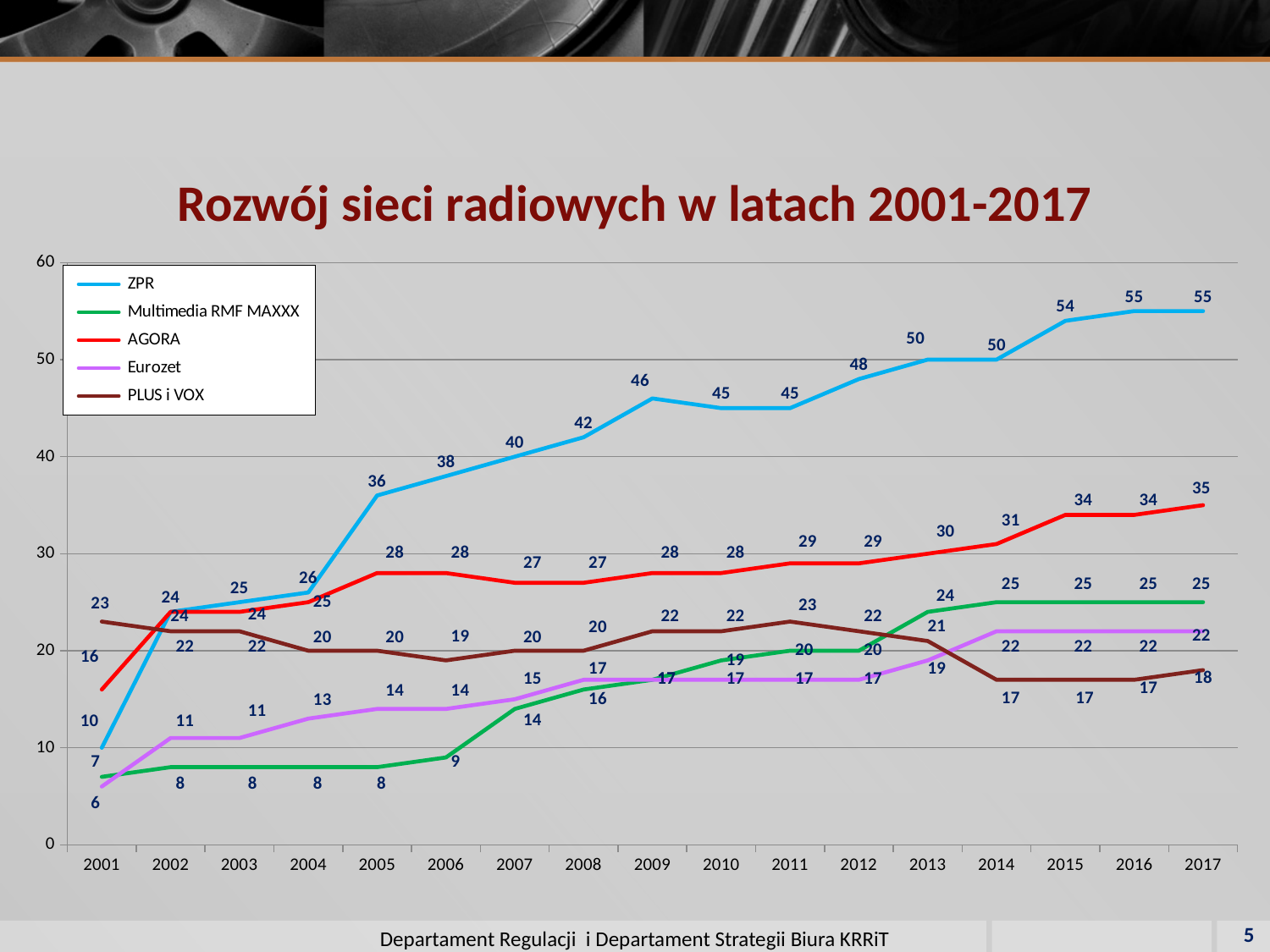
What is the difference between the ZPR value in 2017 and the ZPR value in 2001? 45 Which is larger in 2001: the value for PLUS i VOX or the value for AGORA? PLUS i VOX What is the value for ZPR in 2017? 55 How many series does the legend list? 5 What is the value for PLUS i VOX in 2014? 17 Does the ZPR series generally rise or fall from 2001 to 2017? rise What is the title of the chart? Rozwój sieci radiowych w latach 2001-2017 What is the value for AGORA in 2005? 28 What is the value for Eurozet in 2001? 6 Which series has the lowest value in 2001? Eurozet What type of chart is shown on the slide? line chart Which series has the highest value in 2017? ZPR